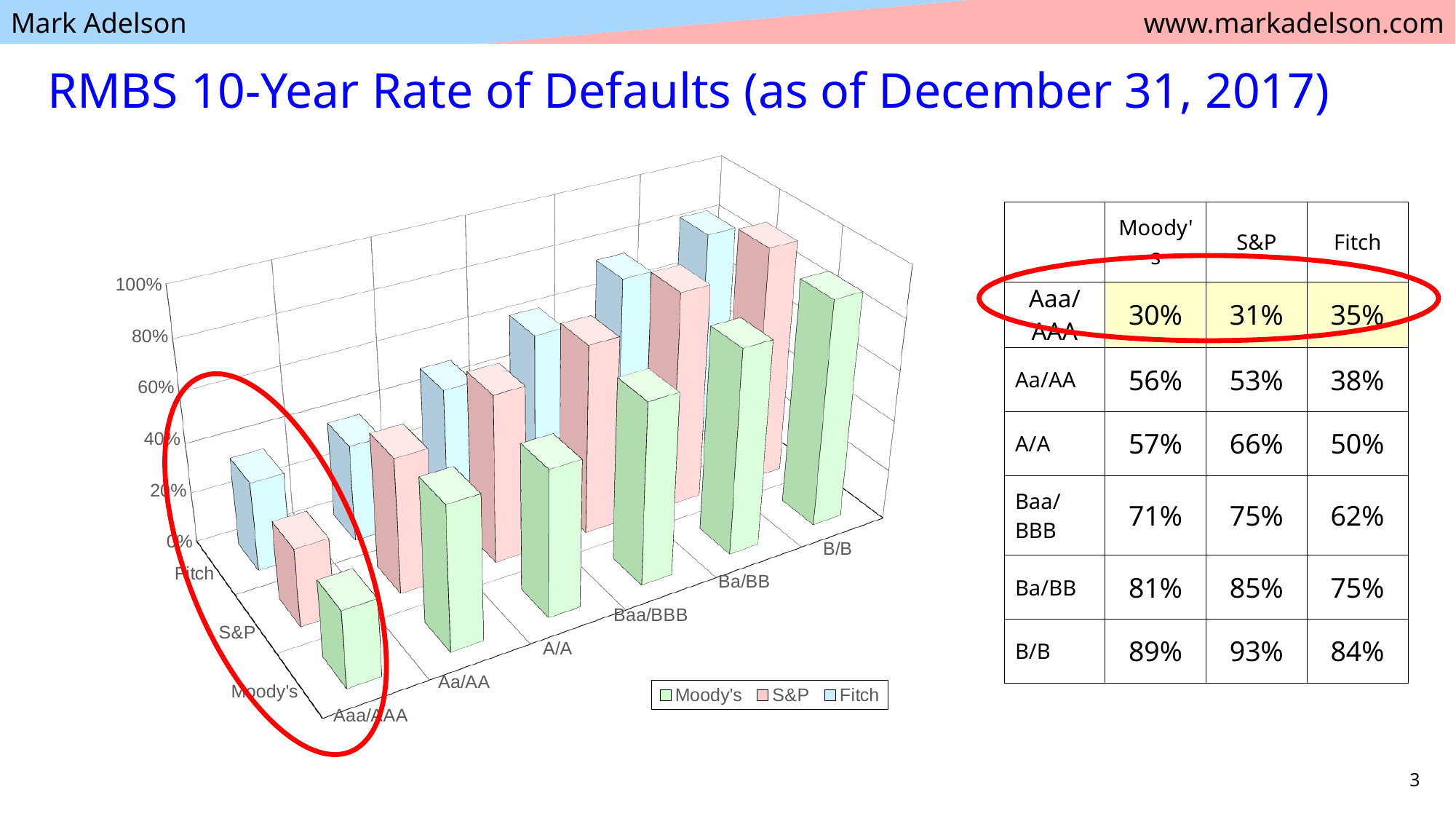
How many rating categories are shown on the chart's category axis? 6 For Aa/AA-rated RMBS, which is larger: the Moody's default rate or the Fitch default rate? Moody's Which rating category has the highest default rate for S&P? B/B What is the difference between the S&P and Moody's default rates for B/B-rated RMBS? 4% How many series does the chart legend list? 3 Which rating category has the lowest default rate for Fitch? Aaa/AAA What is the title of the chart on the slide? RMBS 10-Year Rate of Defaults (as of December 31, 2017) What is the 10-year default rate for Fitch B/B-rated RMBS? 84% What is the 10-year default rate for S&P A/A-rated RMBS? 66% What kind of chart is shown on the slide? Bar chart What is the 10-year default rate for Moody's Aaa/AAA-rated RMBS? 30% Do the Moody's default rates rise or fall as the rating moves from Aaa/AAA to B/B? Rise